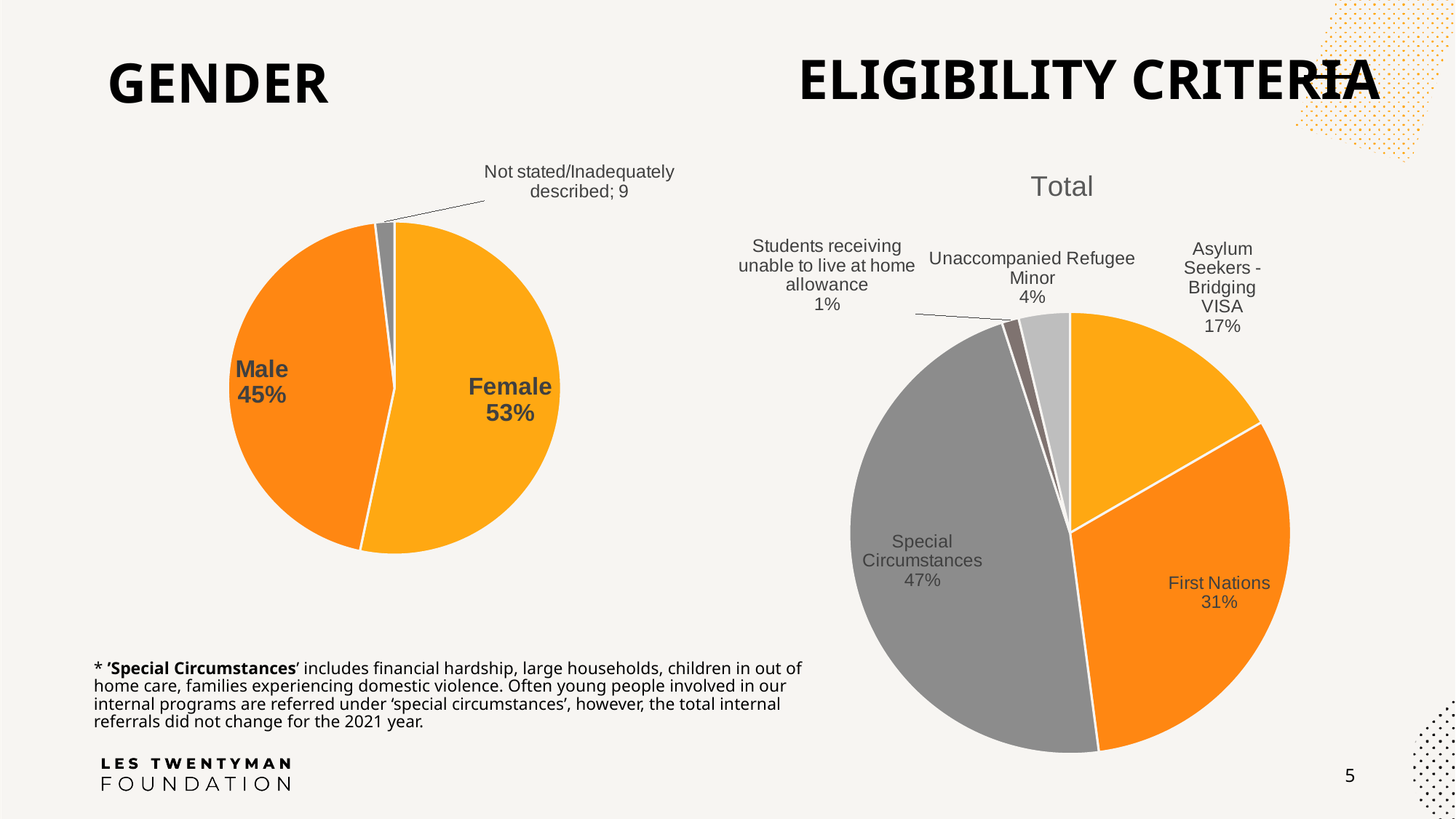
In the Gender chart, what share of the pie is Female? 53% In the Gender chart, how many slices does the pie have? 3 In the Gender chart, what share of the pie is Male? 45% What type of chart is used for the Eligibility Criteria data? Pie chart In the Eligibility Criteria chart, which is larger: Asylum Seekers - Bridging VISA or Unaccompanied Refugee Minor? Asylum Seekers - Bridging VISA In the Eligibility Criteria chart, what share of the pie is Special Circumstances? 47% In the Eligibility Criteria chart, which category has the smallest slice? Students receiving unable to live at home allowance In the Eligibility Criteria chart, how many categories are shown in the pie? 5 In the Gender chart, which category has the largest slice? Female In the Gender chart, what value is shown for the 'Not stated/Inadequately described' slice? 9 In the Gender chart, what is the difference in percentage points between Female and Male? 8